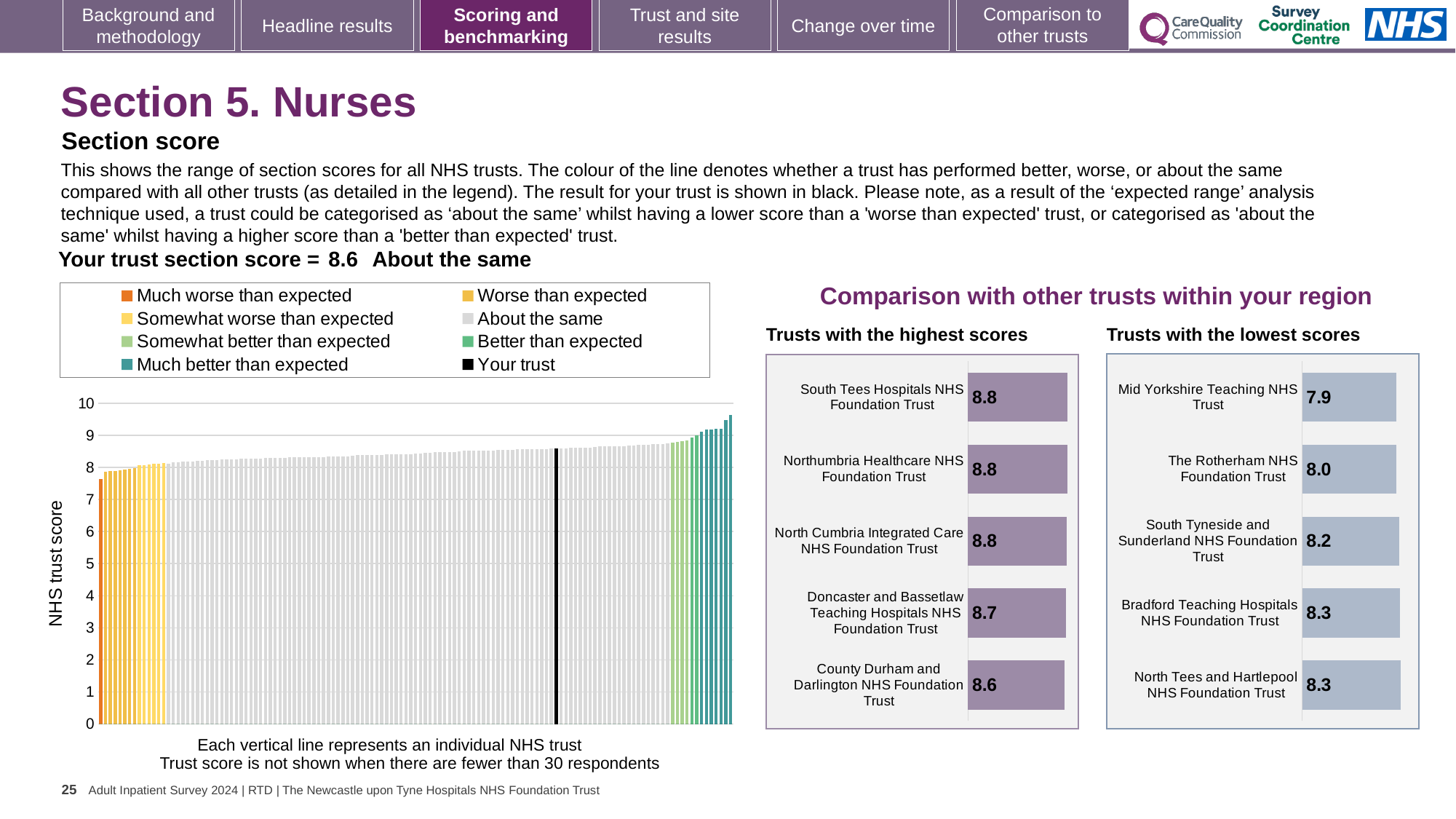
How many trusts are listed in the 'Trusts with the highest scores' chart? 5 In the 'Trusts with the lowest scores' chart, which trust has the lowest score? Mid Yorkshire Teaching NHS Trust In the 'Trusts with the lowest scores' chart, what is the difference between the score for South Tyneside and Sunderland NHS Foundation Trust and Mid Yorkshire Teaching NHS Trust? 0.3 In the 'Trusts with the lowest scores' chart, which has the larger score: The Rotherham NHS Foundation Trust or South Tyneside and Sunderland NHS Foundation Trust? South Tyneside and Sunderland NHS Foundation Trust In the 'Trusts with the highest scores' chart, which trust has the lowest score? County Durham and Darlington NHS Foundation Trust In the large chart on the left showing all NHS trusts, do the values rise or fall from left to right? rise In the large chart on the left showing all NHS trusts, is the value for the lowest (leftmost) trust greater or less than 8? less In the 'Trusts with the highest scores' chart, what is the difference between the score for South Tees Hospitals NHS Foundation Trust and County Durham and Darlington NHS Foundation Trust? 0.2 In the 'Trusts with the highest scores' chart, what is the score for Doncaster and Bassetlaw Teaching Hospitals NHS Foundation Trust? 8.7 In the large chart on the left showing all NHS trusts, is the value for the highest (rightmost) trust greater or less than 9? greater How many entries does the legend of the large chart on the left list? 8 In the 'Trusts with the lowest scores' chart, what is the score for The Rotherham NHS Foundation Trust? 8.0